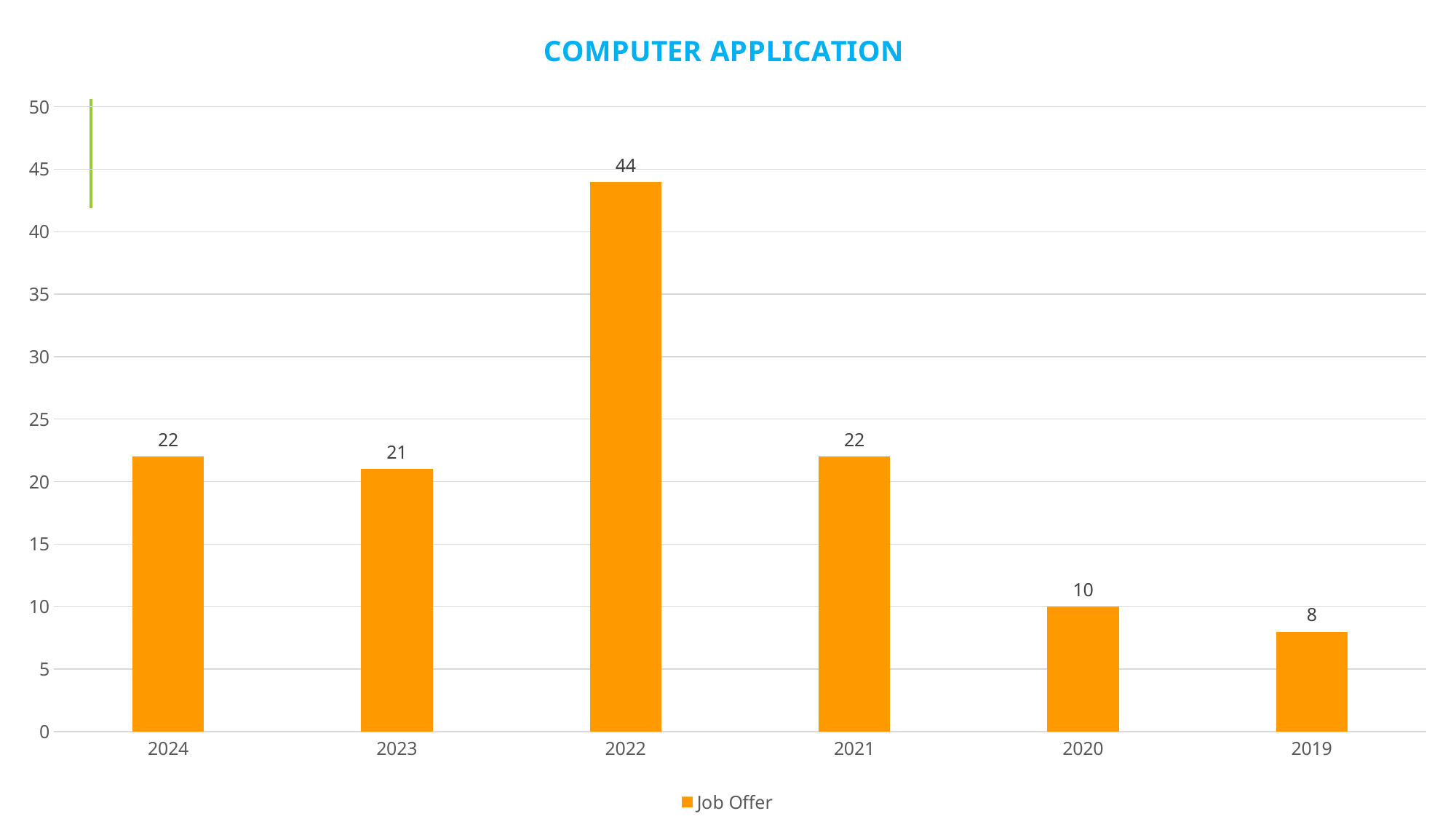
What is the title of the chart? COMPUTER APPLICATION What is the difference between the Job Offer values for 2022 and 2021? 22 What kind of chart is shown on the slide? bar chart What is the Job Offer value for 2019? 8 Which year has the lowest Job Offer value? 2019 Which year has the highest Job Offer value? 2022 What is the Job Offer value for 2023? 21 What is the difference between the Job Offer values for 2020 and 2019? 2 How many years are shown on the x axis? 6 What is the Job Offer value for 2022? 44 Is the Job Offer value for 2022 greater or less than 40? greater Which is larger, the Job Offer value for 2023 or for 2020? 2023